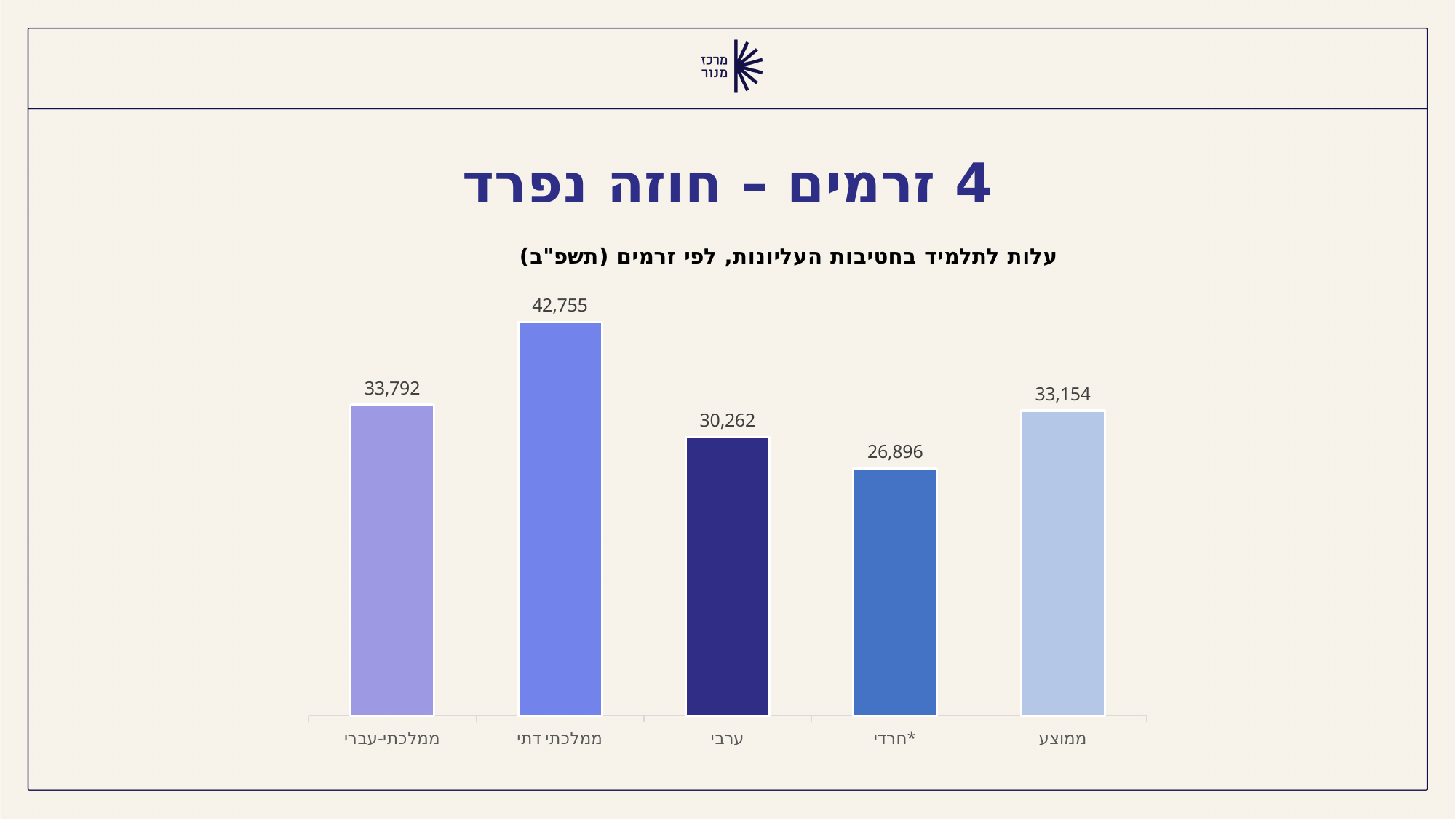
What is the title of the chart? עלות לתלמיד בחטיבות העליונות, לפי זרמים (תשפ"ב) What is the value for ממלכתי דתי? 42,755 What is the difference between the values for ממלכתי דתי and חרדי*? 15,859 Which category has the highest value? ממלכתי דתי What is the value for ממוצע? 33,154 Which is larger, the value for ממלכתי-עברי or the value for ערבי? ממלכתי-עברי How many categories are shown in the chart? 5 What is the difference between the values for ממלכתי-עברי and ממוצע? 638 What is the value for חרדי*? 26,896 Which category has the lowest value? חרדי* What is the value for ערבי? 30,262 What kind of chart is shown on the slide? Bar chart